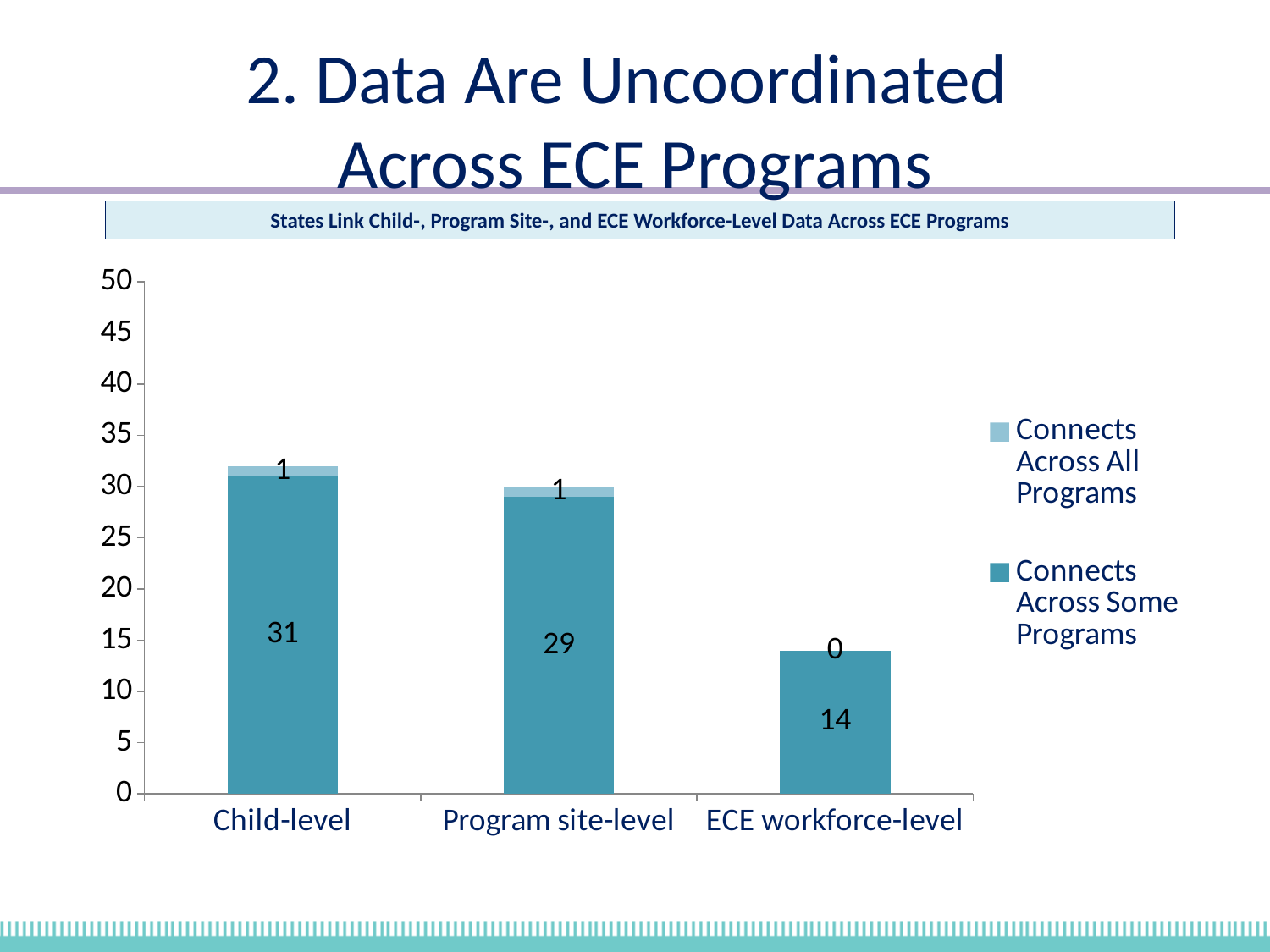
How many categories are shown on the x axis? 3 Which category has the highest value for 'Connects Across Some Programs'? Child-level How many series does the legend list? 2 What is the total of the stacked bar for Program site-level? 30 What is the value for 'Connects Across Some Programs' at Program site-level? 29 What kind of chart is shown on the slide? Stacked bar chart What is the difference between the 'Connects Across Some Programs' values for Child-level and ECE workforce-level? 17 Which category has the lowest value for 'Connects Across Some Programs'? ECE workforce-level What is the value for 'Connects Across Some Programs' at ECE workforce-level? 14 What is the total of the stacked bar for Child-level? 32 What is the value for 'Connects Across Some Programs' at Child-level? 31 What is the value for 'Connects Across All Programs' at ECE workforce-level? 0